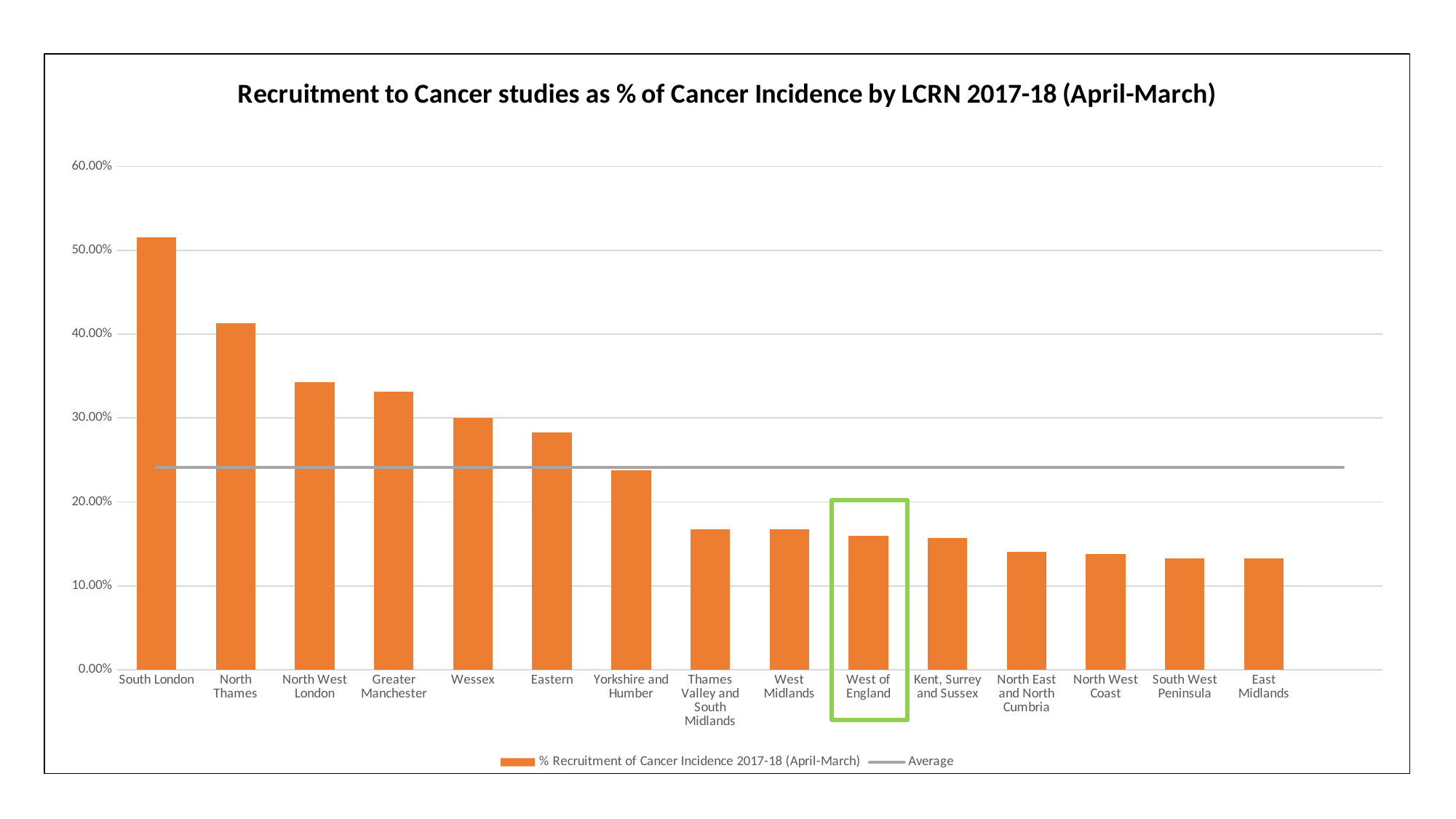
Do the bar values rise or fall moving from left to right along the x axis? fall Which is larger, the value for Eastern or the value for Yorkshire and Humber? Eastern How many entries does the legend list? 2 Which LCRN has the highest recruitment as % of cancer incidence? South London Is the value for West of England greater or less than 20.00%? less Is the value for Eastern greater or less than 30.00%? less Which LCRN is highlighted with a green box on the chart? West of England What kind of chart is shown on the slide? bar chart Is the value for East Midlands greater or less than 10.00%? greater How many LCRN categories are plotted on the x axis? 15